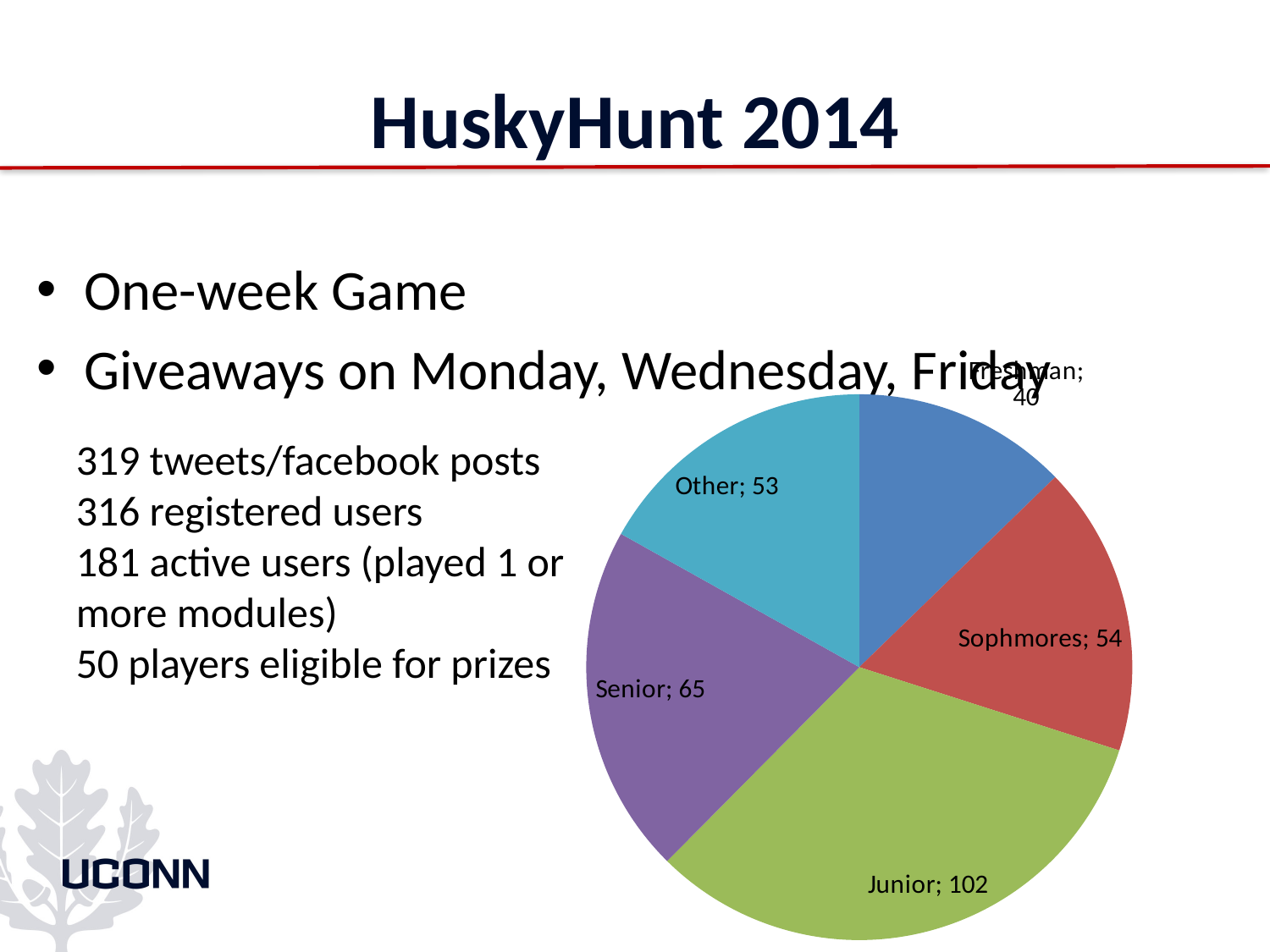
What is the value for Sophmores in the pie chart? 54 How many slices does the pie chart have? 5 What is the value for Other in the pie chart? 53 What colour is the Junior slice in the pie chart? Green What kind of chart is shown on the slide? Pie chart What is the value for Junior in the pie chart? 102 What is the difference between the Senior and Sophmores values in the pie chart? 11 Which is larger in the pie chart, Junior or Senior? Junior What is the value for Senior in the pie chart? 65 Which category has the largest slice in the pie chart? Junior Which is larger in the pie chart, Senior or Other? Senior What is the difference between the Junior and Senior values in the pie chart? 37